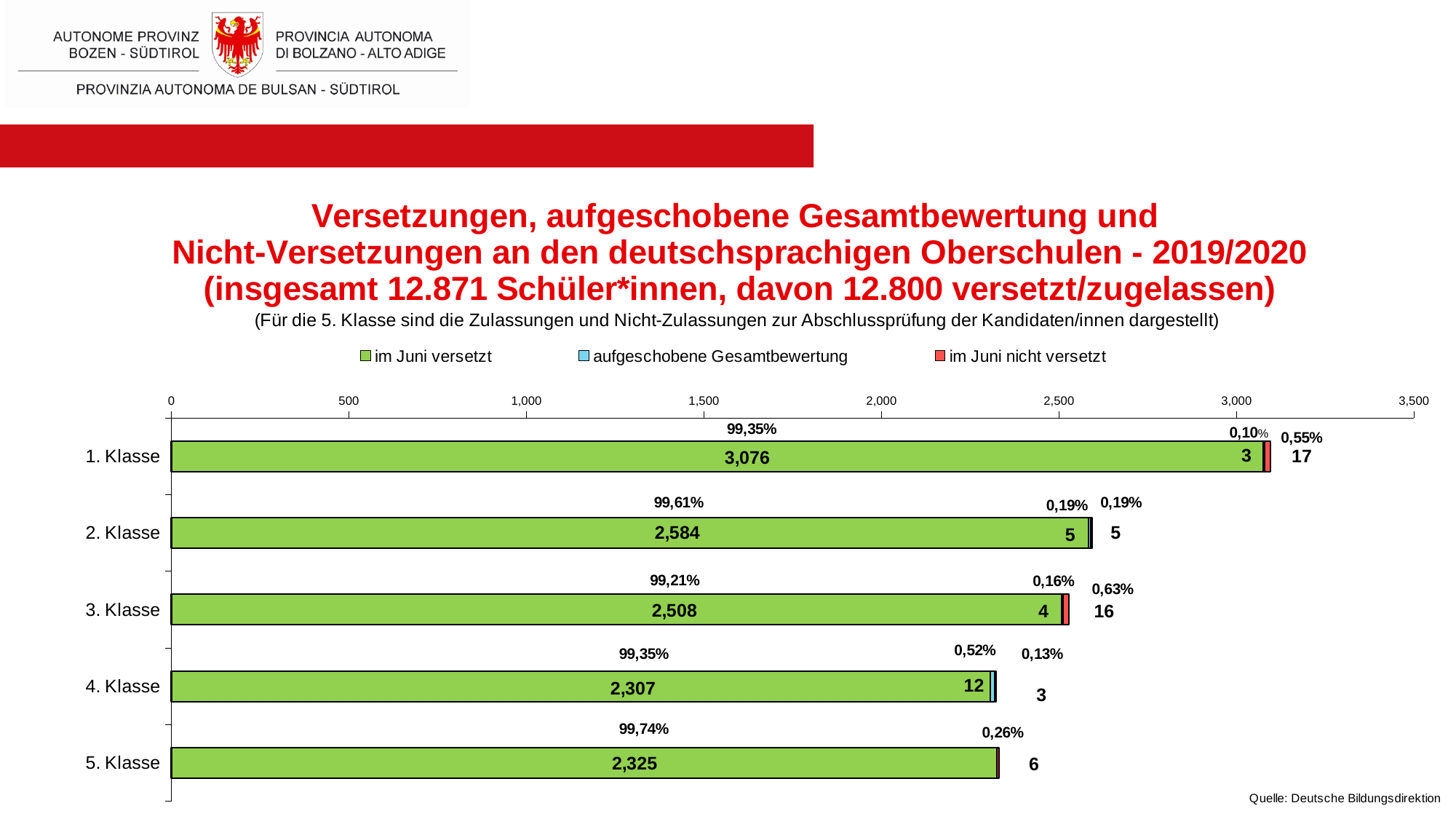
Which has a larger "im Juni versetzt" value, 3. Klasse or 5. Klasse? 3. Klasse How many classes (categories) are shown on the chart? 5 Which class has the highest value for "im Juni versetzt"? 1. Klasse What is the value of "aufgeschobene Gesamtbewertung" for 4. Klasse? 12 What is the difference between the "im Juni versetzt" values of 1. Klasse and 2. Klasse? 492 What percentage label is shown for "im Juni versetzt" in 2. Klasse? 99,61% How many students are shown as "im Juni nicht versetzt" for 3. Klasse? 16 Is the "im Juni versetzt" value for 2. Klasse greater or less than 2,500? greater What is the total of the stacked bar for 1. Klasse? 3,096 Which class has the lowest value for "im Juni versetzt"? 4. Klasse How many series does the legend list? 3 What is the value of "im Juni versetzt" for 1. Klasse? 3,076